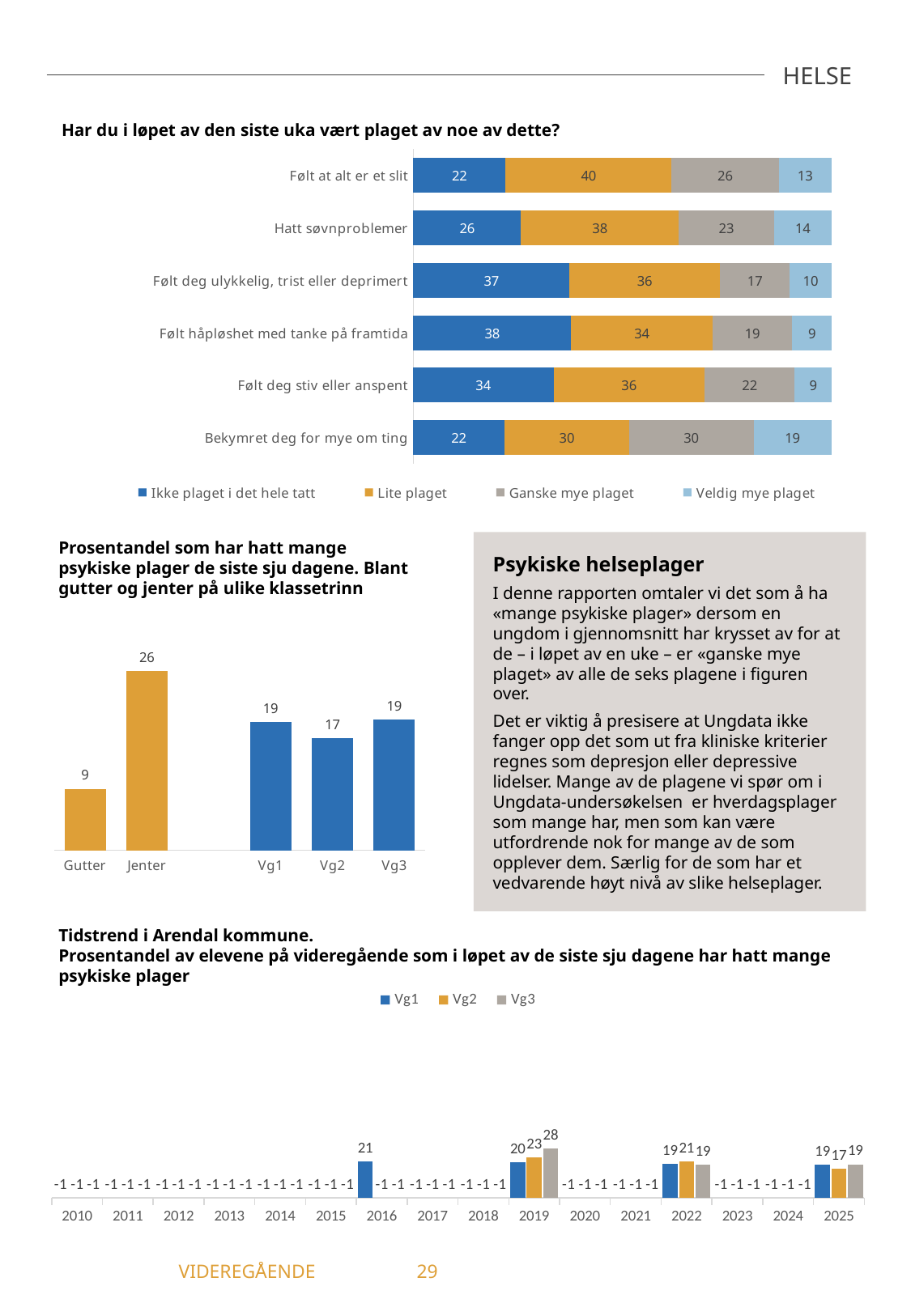
What kind of chart is 'Tidstrend i Arendal kommune'? Bar chart In the chart 'Har du i løpet av den siste uka vært plaget av noe av dette?', how many categories are shown? 6 In the chart 'Har du i løpet av den siste uka vært plaget av noe av dette?', what is the value for 'Lite plaget' for 'Følt at alt er et slit'? 40 In the chart 'Tidstrend i Arendal kommune', what is the value for Vg3 in 2019? 28 In the chart 'Prosentandel som har hatt mange psykiske plager de siste sju dagene', what is the value for Jenter? 26 In the chart 'Har du i løpet av den siste uka vært plaget av noe av dette?', what is the value for 'Ikke plaget i det hele tatt' for 'Følt håpløshet med tanke på framtida'? 38 In the chart 'Tidstrend i Arendal kommune', which is larger in 2025: Vg1 or Vg2? Vg1 In the chart 'Har du i løpet av den siste uka vært plaget av noe av dette?', which category has the highest value for 'Veldig mye plaget'? Bekymret deg for mye om ting In the chart 'Har du i løpet av den siste uka vært plaget av noe av dette?', how many series does the legend list? 4 In the chart 'Prosentandel som har hatt mange psykiske plager de siste sju dagene', what is the difference between Jenter and Gutter? 17 In the chart 'Prosentandel som har hatt mange psykiske plager de siste sju dagene', which category has the lowest value? Gutter In the chart 'Har du i løpet av den siste uka vært plaget av noe av dette?', what is the difference between 'Ganske mye plaget' for 'Bekymret deg for mye om ting' and for 'Følt deg ulykkelig, trist eller deprimert'? 13